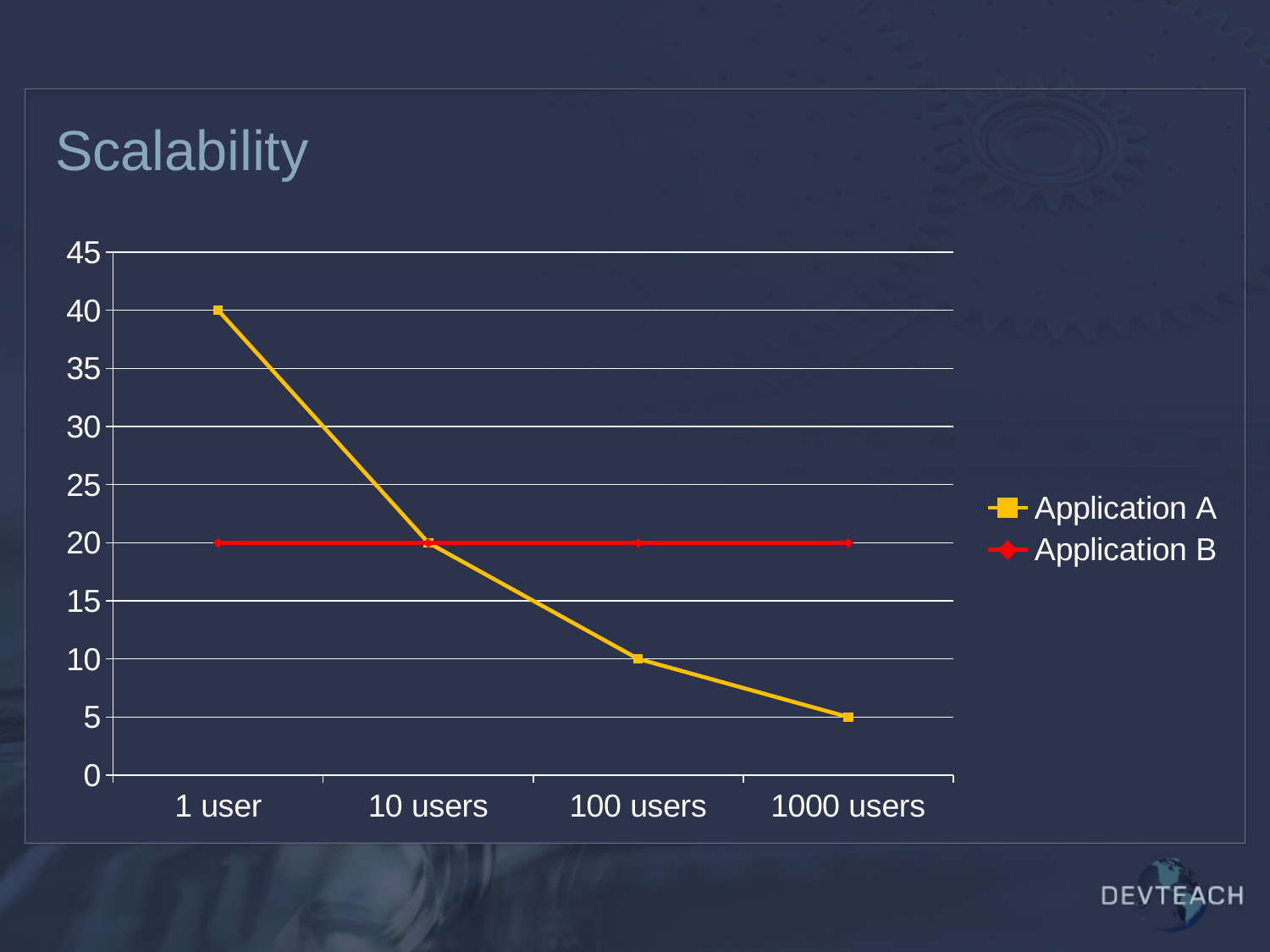
At which category is Application A highest? 1 user How many categories are shown on the x axis? 4 What kind of chart is shown on the slide? line chart What is the value for Application A at 1 user? 40 What is the difference between Application A and Application B at 1 user? 20 Which is larger at 100 users, Application A or Application B? Application B How many series does the legend list? 2 Does the value for Application A rise or fall from 1 user to 1000 users? fall What is the title of the chart? Scalability What is the value for Application B at 100 users? 20 What is the value for Application A at 1000 users? 5 At which category is Application A lowest? 1000 users